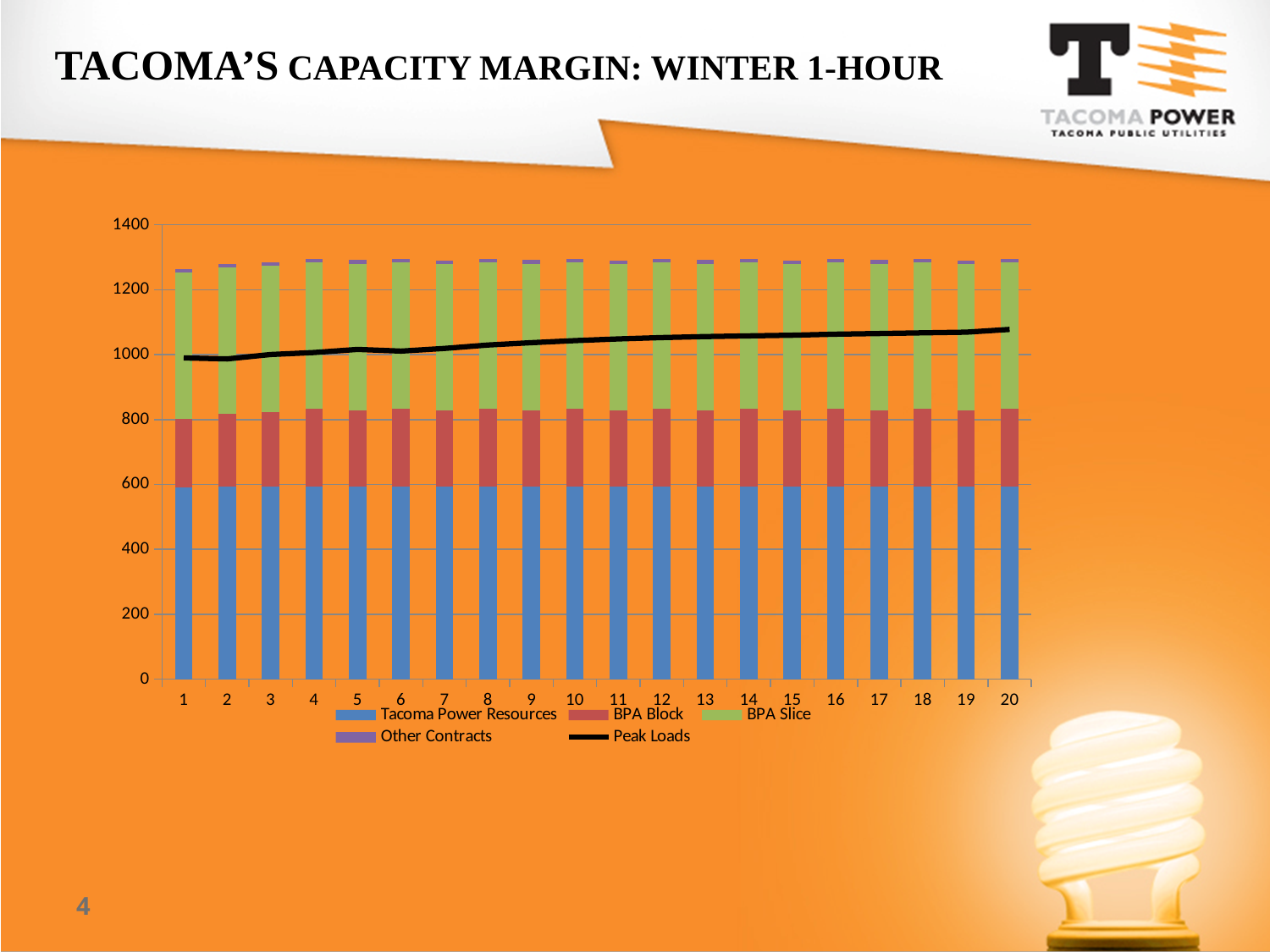
Is the Peak Loads value at category 20 greater or less than 1200? less What kind of chart is shown on the slide? combination bar and line chart Does the Peak Loads line rise or fall from category 1 to category 20? rise Is the total height of the stacked bar at category 20 greater or less than 1400? less How many series does the chart's legend list? 5 How many categories are shown along the x axis of the chart? 20 Is the Tacoma Power Resources value at category 10 greater or less than 400? greater What is the title of the slide containing the chart? TACOMA'S CAPACITY MARGIN: WINTER 1-HOUR Which series is drawn as a black line in the chart? Peak Loads